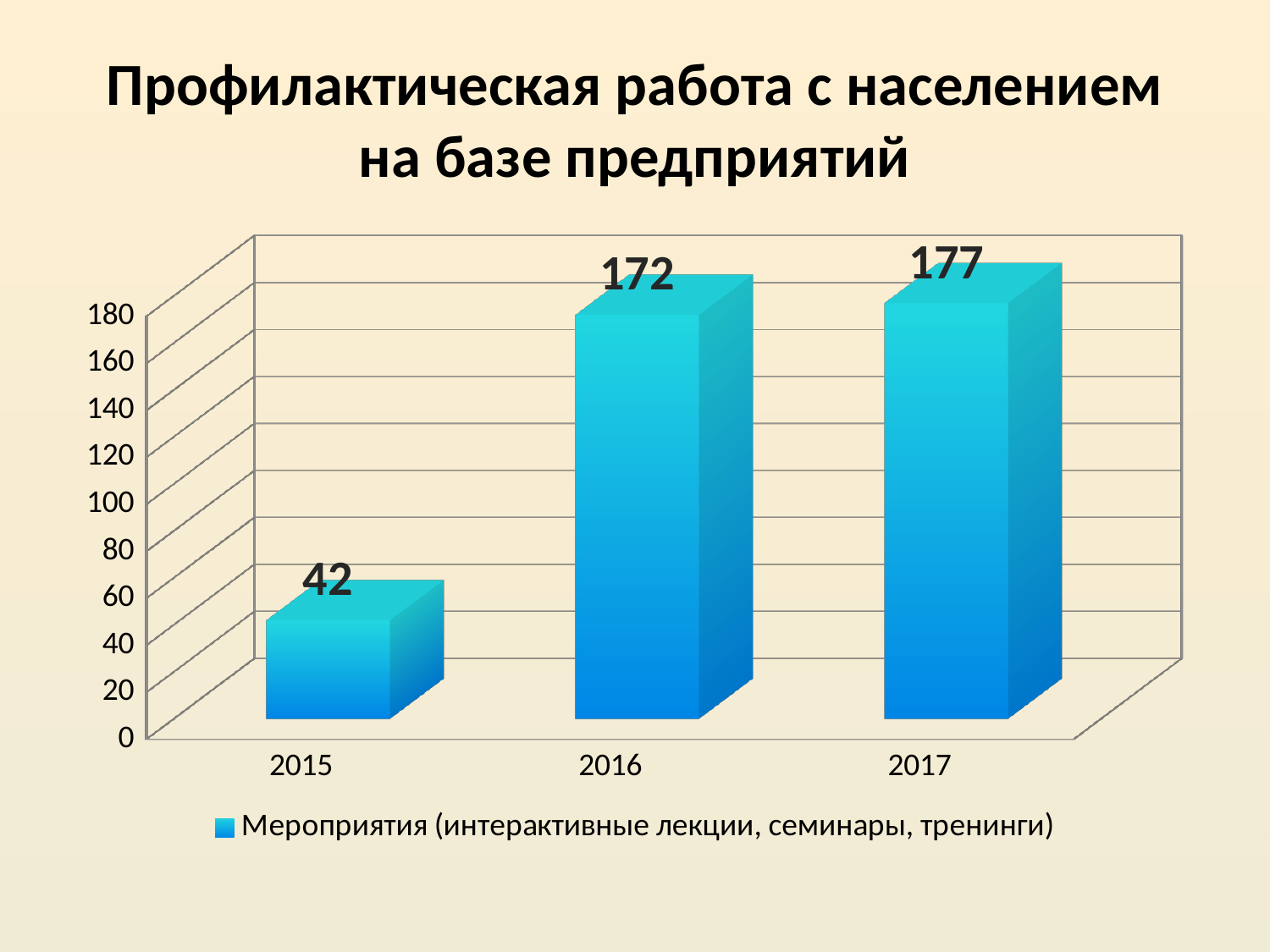
Which is larger, the value for 2015 or the value for 2016? 2016 How many years are shown on the x axis? 3 What is the value for 2016? 172 Which year has the lowest value? 2015 What kind of chart is shown on the slide? bar chart What is the difference between the values for 2016 and 2015? 130 What is the value for 2017? 177 Which year has the highest value? 2017 Do the values rise or fall from 2015 to 2017? rise What is the difference between the values for 2017 and 2016? 5 How many series does the legend list? 1 What is the value for 2015? 42